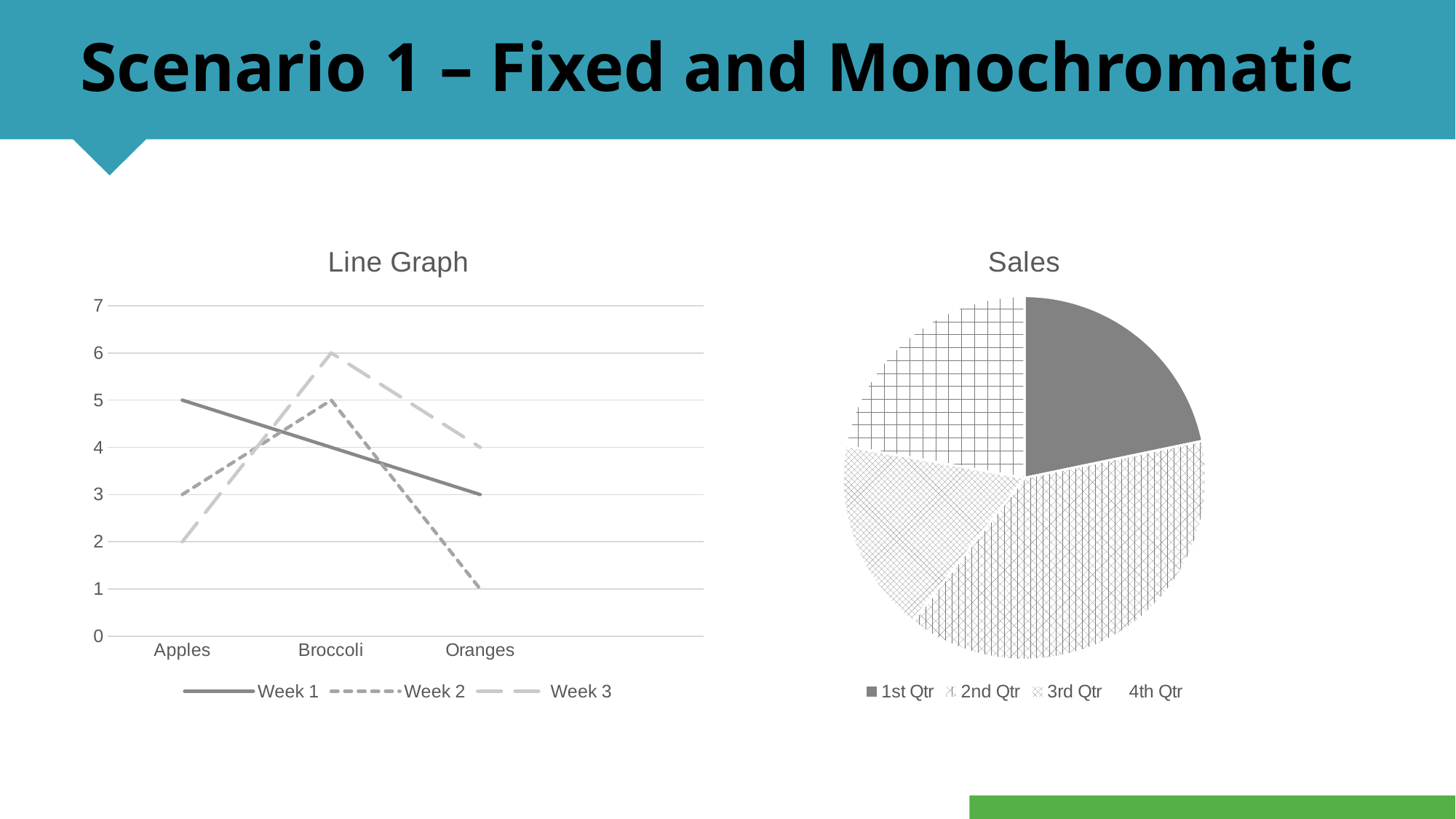
On the Line Graph chart, what is the value for Week 2 at Oranges? 1 On the Line Graph chart, does the Week 1 series rise or fall from Apples to Oranges? fall On the Line Graph chart, what is the difference between the Week 3 value at Broccoli and the Week 3 value at Apples? 4 On the Sales chart, which quarter has the largest slice? 2nd Qtr On the Line Graph chart, which category has the lowest value for Week 2? Oranges What kind of chart is the Sales chart? pie chart On the Line Graph chart, which category has the highest value for Week 3? Broccoli How many series does the legend of the Line Graph chart list? 3 How many slices does the Sales pie chart have? 4 On the Line Graph chart, which is larger at Oranges: Week 1 or Week 3? Week 3 On the Line Graph chart, what is the value for Week 3 at Broccoli? 6 On the Line Graph chart, what is the value for Week 1 at Apples? 5